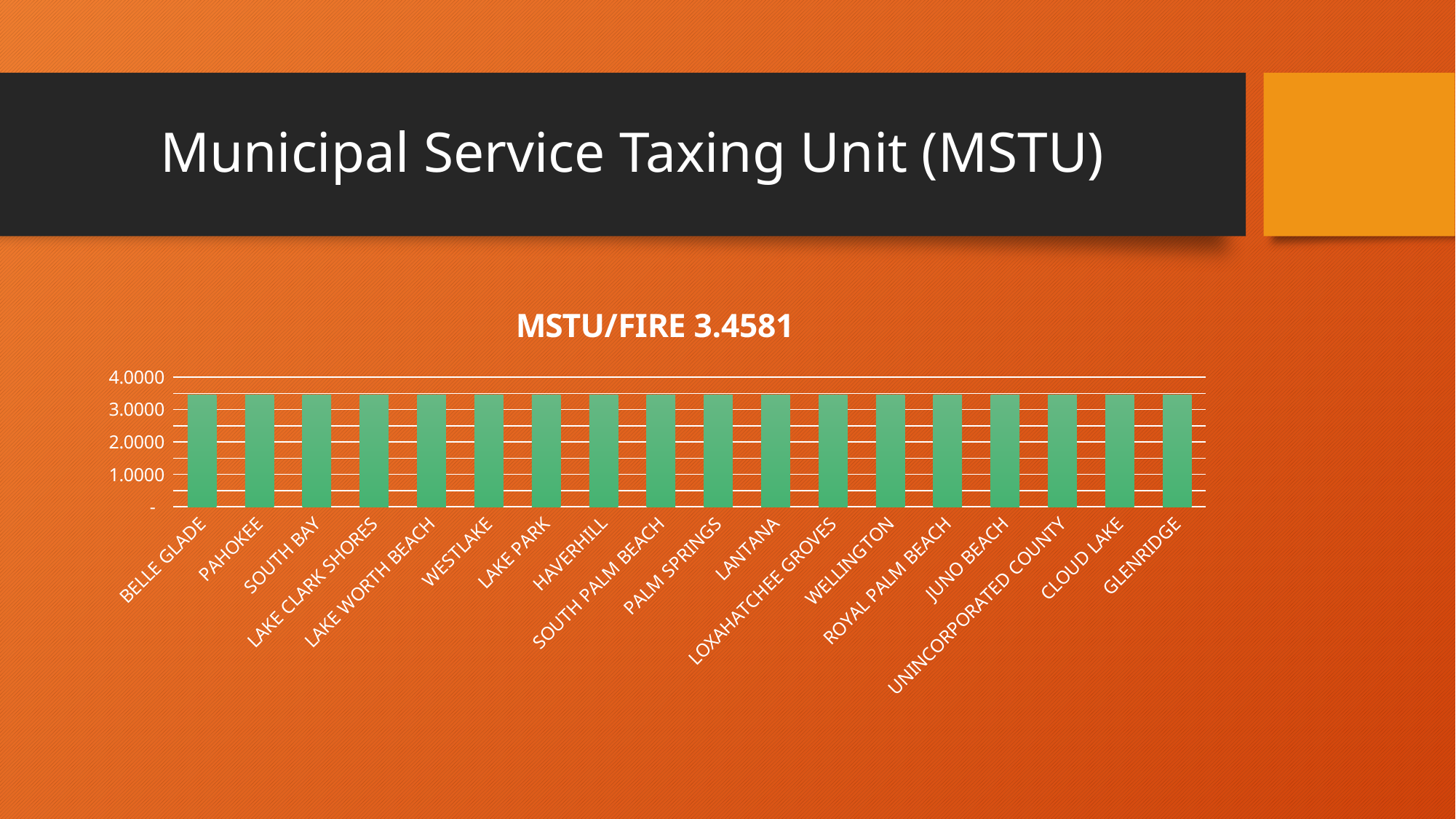
Which category is plotted first (leftmost) on the x axis? BELLE GLADE Is the value for GLENRIDGE greater or less than 2.0000? greater Which category is plotted last (rightmost) on the x axis? GLENRIDGE Is the value for BELLE GLADE greater or less than 3.0000? greater Do the bar values rise, fall, or stay flat moving from left to right along the x axis? stay flat What kind of chart is shown on the slide? bar chart How many categories are plotted on the x axis of the chart? 18 What is the title of the chart? MSTU/FIRE 3.4581 Is the value for UNINCORPORATED COUNTY greater or less than 3.0000? greater What is the highest value shown on the vertical axis of the chart? 4.0000